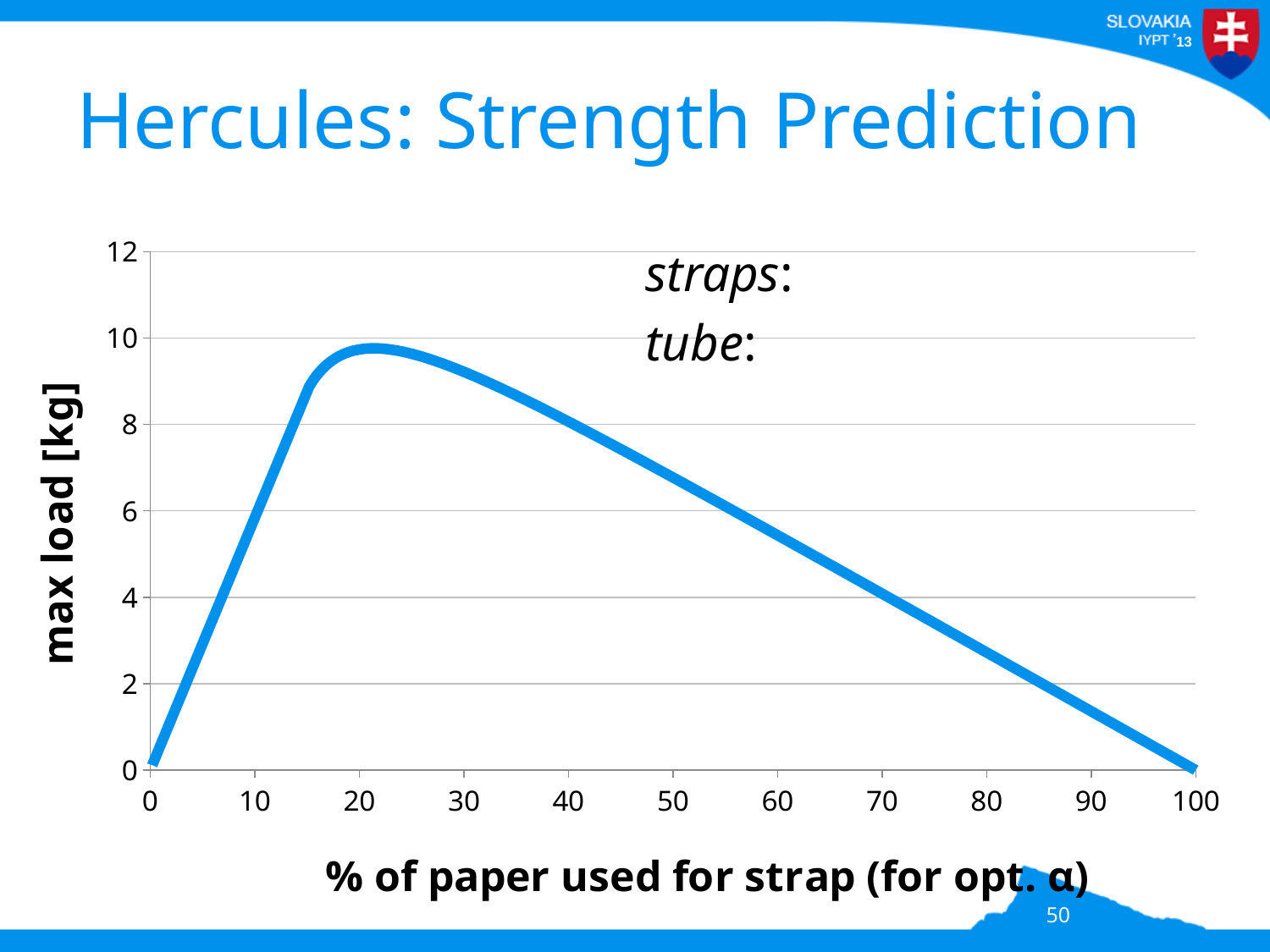
Is the max load at 20% of paper used for strap greater or less than 8 kg? greater Is the peak max load on the curve greater or less than 10 kg? less Is the max load at 50% of paper used for strap greater or less than 6 kg? greater What is the label of the horizontal axis? % of paper used for strap (for opt. α) What kind of chart is shown on the slide? line chart What is the max load when 100% of the paper is used for the strap? 0 Which is larger, the max load at 30% or at 70% of paper used for strap? 30% What is the label of the vertical axis? max load [kg] Does the max load rise or fall as the % of paper used for strap increases from 20 to 100? fall Does the max load rise or fall as the % of paper used for strap increases from 0 to 15? rise